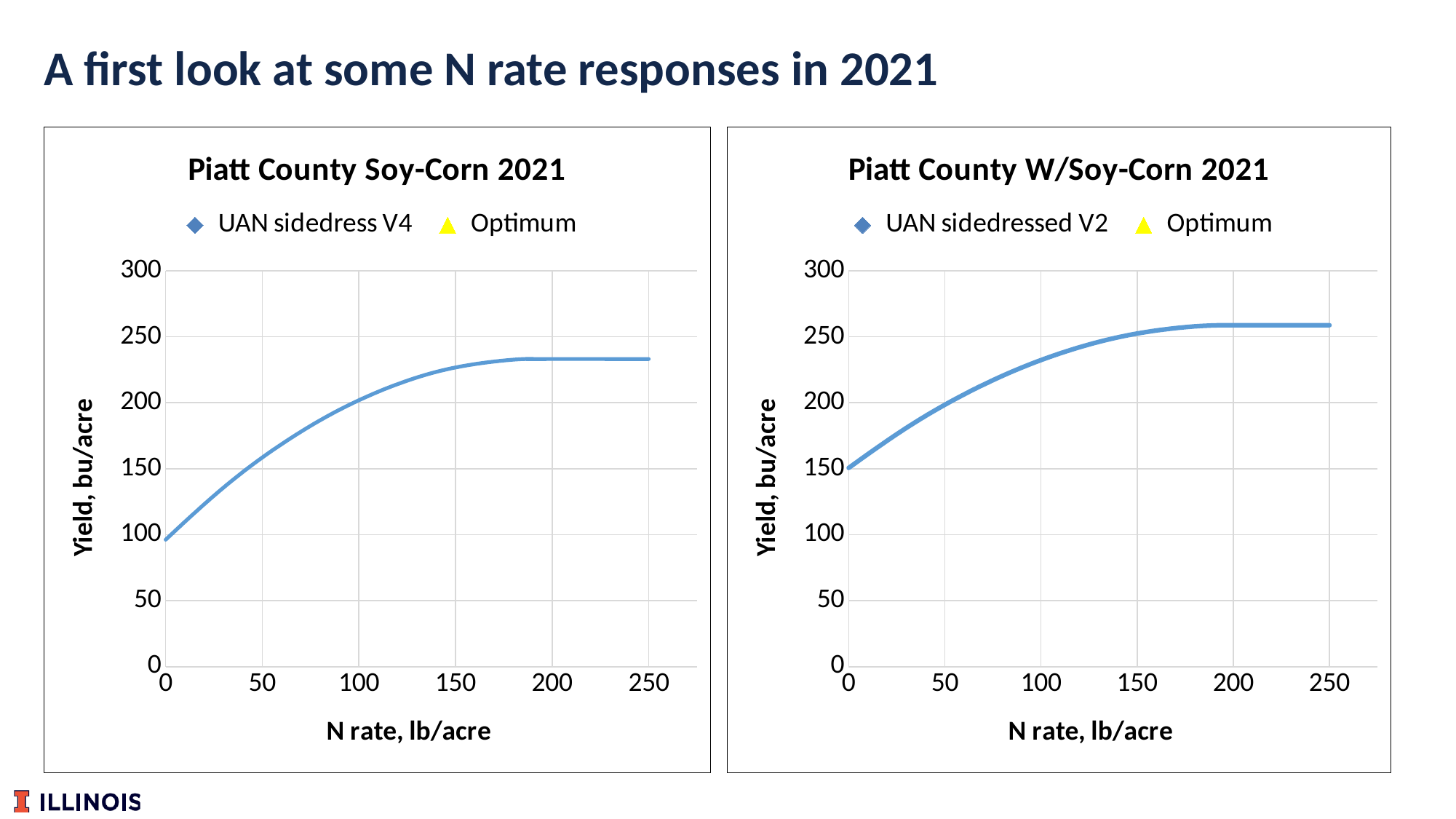
In the Piatt County W/Soy-Corn 2021 chart, does yield rise or fall as N rate increases from 0 to 150 lb/acre? rise In the Piatt County W/Soy-Corn 2021 chart, is the yield at an N rate of 0 greater or less than 100 bu/acre? greater What is the name of the first series in the legend of the Piatt County Soy-Corn 2021 chart? UAN sidedress V4 What is the y-axis label of the Piatt County W/Soy-Corn 2021 chart? Yield, bu/acre What kind of chart is the Piatt County Soy-Corn 2021 chart? line chart In the Piatt County Soy-Corn 2021 chart, is the yield at an N rate of 250 greater or less than 250 bu/acre? less In the Piatt County Soy-Corn 2021 chart, does yield rise or fall as N rate increases from 0 to 150 lb/acre? rise In the Piatt County W/Soy-Corn 2021 chart, is the yield at an N rate of 100 greater or less than 200 bu/acre? greater How many series does the legend of the Piatt County W/Soy-Corn 2021 chart list? 2